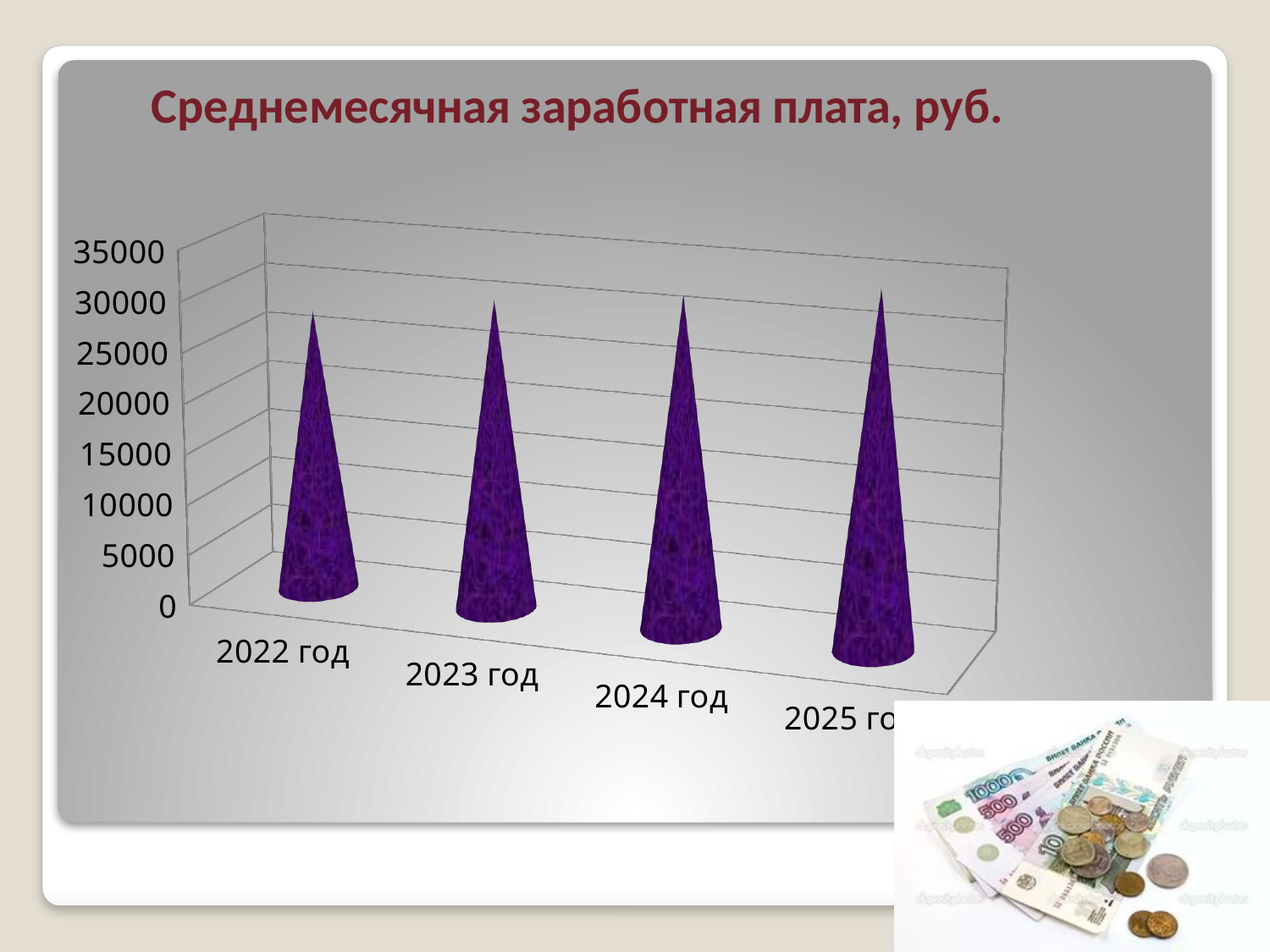
Which year has the lowest average monthly salary on the chart? 2022 год Is the value for 2025 год greater or less than 35000? less Do the values rise or fall from 2022 to 2025 along the x axis? rise What is the title of the chart? Среднемесячная заработная плата, руб. What is the highest value shown on the vertical axis? 35000 How many years (categories) are plotted on the chart? 4 Which is larger, the value for 2022 год or the value for 2025 год? 2025 год Which year has the highest average monthly salary on the chart? 2025 год Is the value for 2024 год greater or less than 15000? greater Is the value for 2022 год greater or less than 20000? greater What kind of chart is shown on the slide? bar chart